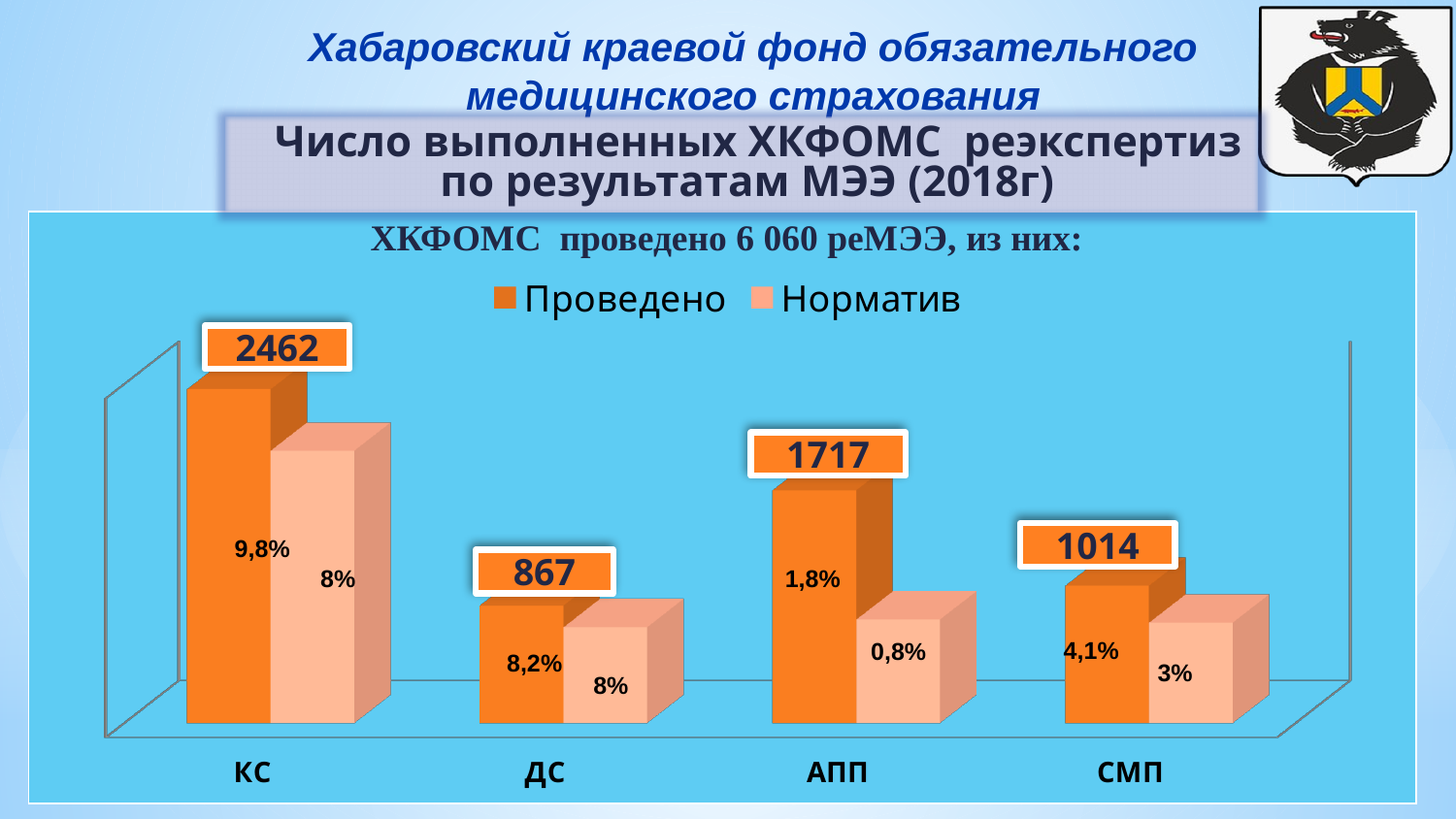
Which category has the lowest Норматив percentage? АПП What percentage is printed on the Норматив bar for АПП? 0,8% How many series does the chart legend list? 2 What type of chart is shown on the slide? bar chart What percentage is printed on the Проведено bar for СМП? 4,1% How many categories are shown along the x axis of the chart? 4 Which category has the highest Проведено value? КС For ДС, which is larger: the Проведено percentage or the Норматив percentage? Проведено What number is shown in the label above the Проведено bar for КС? 2462 What is the difference between the numbers labelled for КС (2462) and ДС (867)? 1595 According to the text above the chart, how many реМЭЭ did ХКФОМС carry out in total? 6 060 What number is shown in the label above the Проведено bar for АПП? 1717